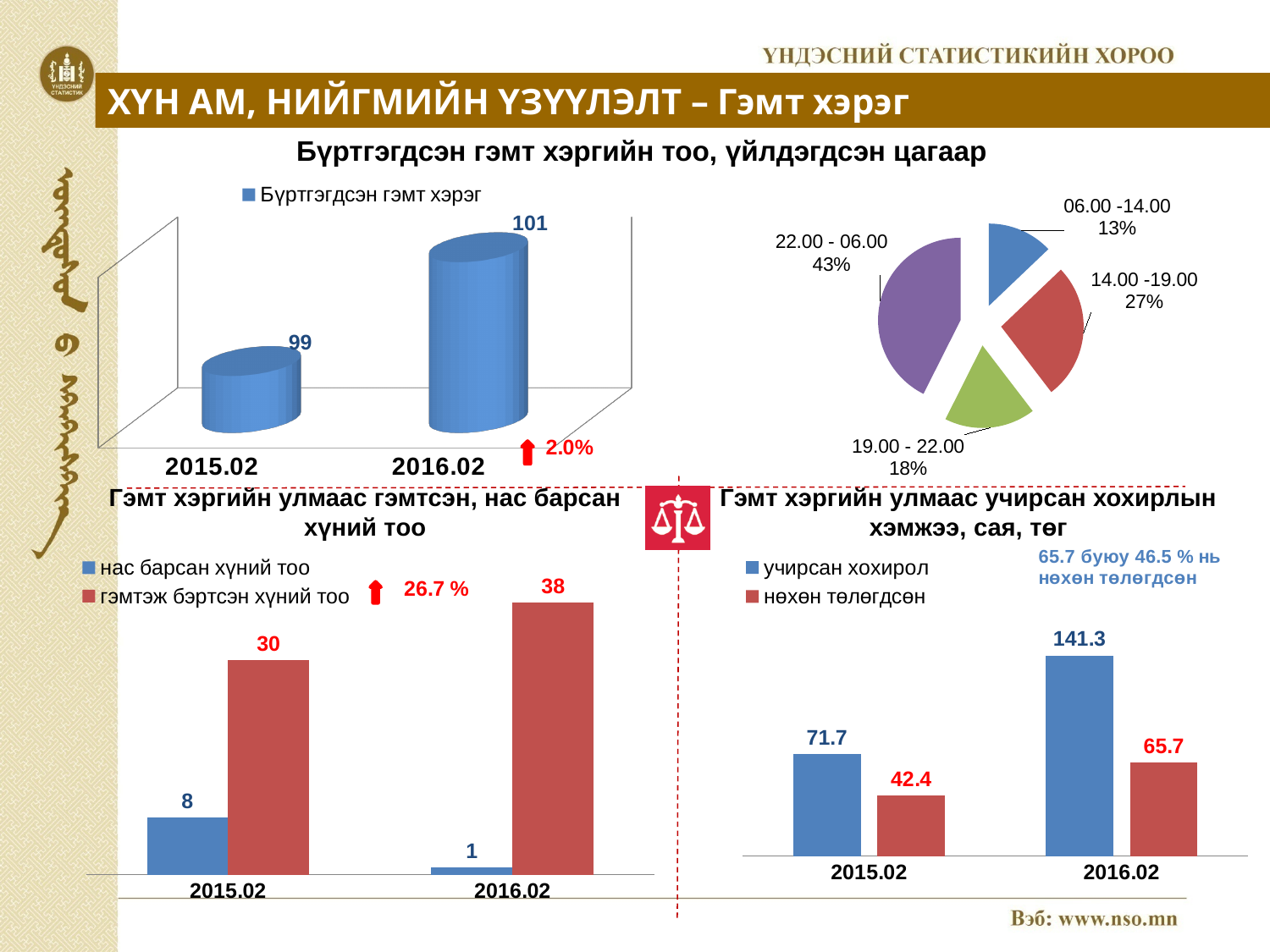
In the bottom-left bar chart, what is the value of гэмтэж бэртсэн хүний тоо for 2016.02? 38 How many slices does the top-right pie chart have? 4 In the top-left bar chart (Бүртгэгдсэн гэмт хэргийн тоо), what is the value for 2015.02? 99 In the bottom-right bar chart, which is larger for 2015.02: учирсан хохирол or нөхөн төлөгдсөн? учирсан хохирол In the top-right pie chart, what share does the 22.00 - 06.00 slice have? 43% In the bottom-left bar chart, what is the value of нас барсан хүний тоо for 2015.02? 8 In the bottom-left bar chart, how many series does the legend list? 2 In the top-left bar chart (Бүртгэгдсэн гэмт хэргийн тоо), what is the value for 2016.02? 101 In the bottom-right bar chart, what is the difference between учирсан хохирол and нөхөн төлөгдсөн for 2016.02? 75.6 In the top-left bar chart, what is the difference between the 2016.02 and 2015.02 values? 2 In the top-right pie chart, which time period has the smallest share? 06.00 -14.00 In the bottom-right bar chart, what is the value of учирсан хохирол for 2016.02? 141.3